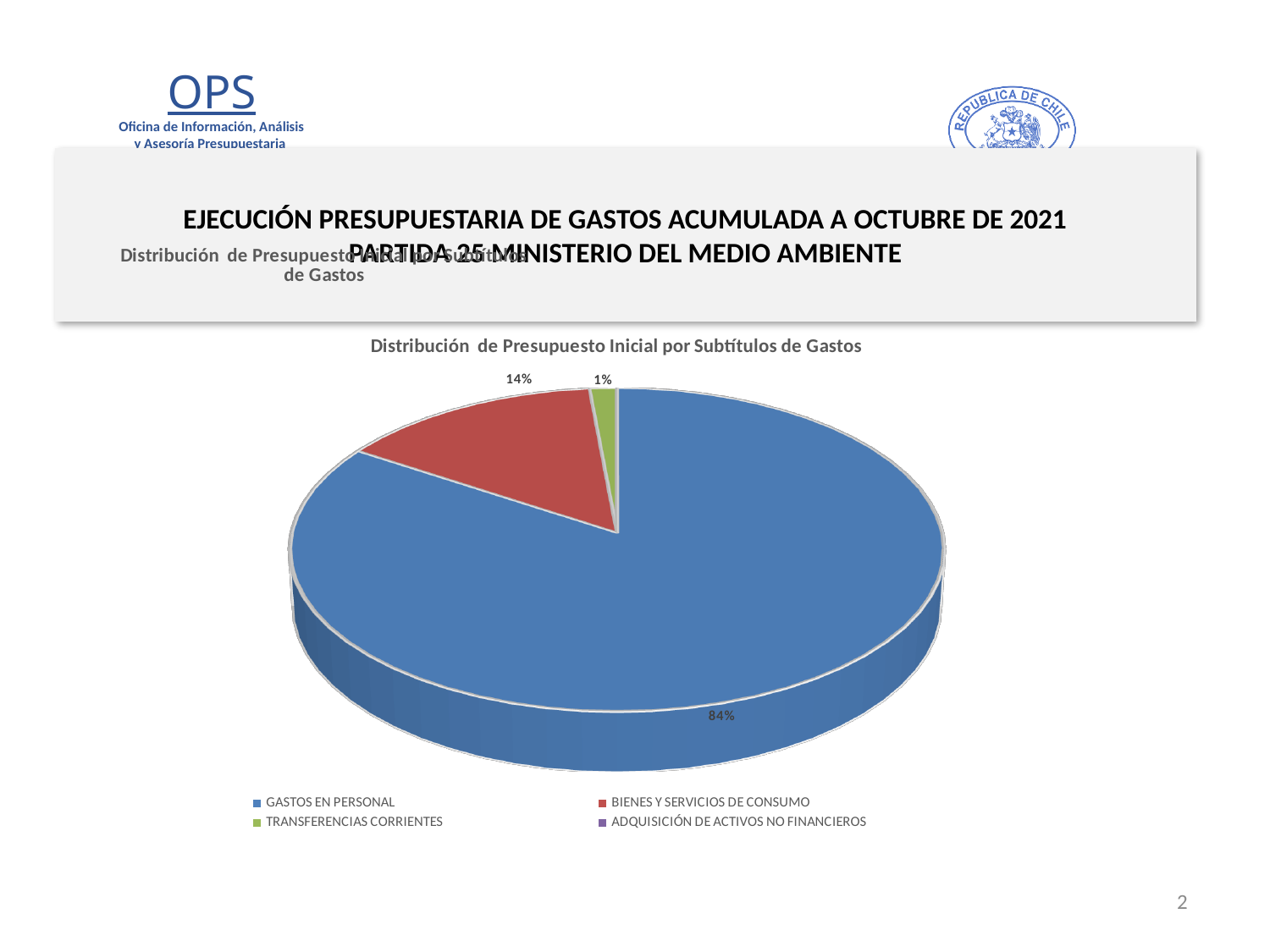
What share of the pie does GASTOS EN PERSONAL represent? 84% What share of the pie does BIENES Y SERVICIOS DE CONSUMO represent? 14% What share of the pie does TRANSFERENCIAS CORRIENTES represent? 1% What is the difference in percentage points between the GASTOS EN PERSONAL slice and the BIENES Y SERVICIOS DE CONSUMO slice? 70 percentage points Which labelled slice is the smallest in the pie? TRANSFERENCIAS CORRIENTES Which category has the largest slice of the pie? GASTOS EN PERSONAL How many categories does the legend list? 4 Which is larger, the BIENES Y SERVICIOS DE CONSUMO slice or the TRANSFERENCIAS CORRIENTES slice? BIENES Y SERVICIOS DE CONSUMO How many slices in the pie have a percentage label? 3 What is the title of the chart? Distribución de Presupuesto Inicial por Subtítulos de Gastos What colour is the GASTOS EN PERSONAL slice? Blue What kind of chart is shown on the slide? Pie chart